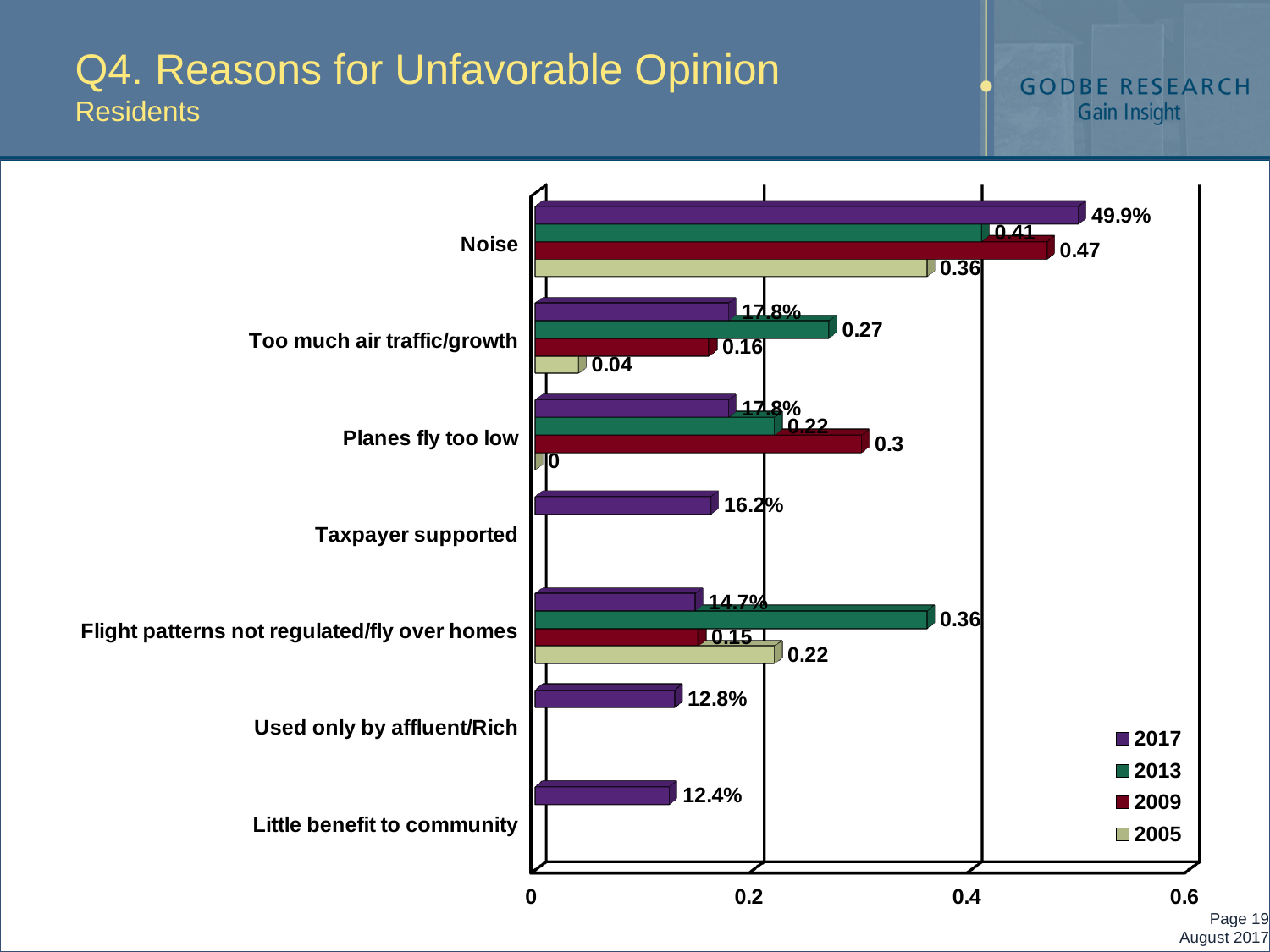
How many categories are shown on the chart? 7 What is the 2017 value for Noise? 49.9% Is the 2013 value for Too much air traffic/growth greater or less than 0.2? greater What is the 2005 value for Too much air traffic/growth? 0.04 Which is larger for Noise: the 2009 value or the 2005 value? 2009 What is the difference between the 2013 and 2009 values for Flight patterns not regulated/fly over homes? 0.21 Which category has the highest 2017 value? Noise How many series does the legend list? 4 What is the 2013 value for Flight patterns not regulated/fly over homes? 0.36 What kind of chart is shown on the slide? Bar chart Which category has the lowest 2005 value? Planes fly too low What is the 2009 value for Planes fly too low? 0.3